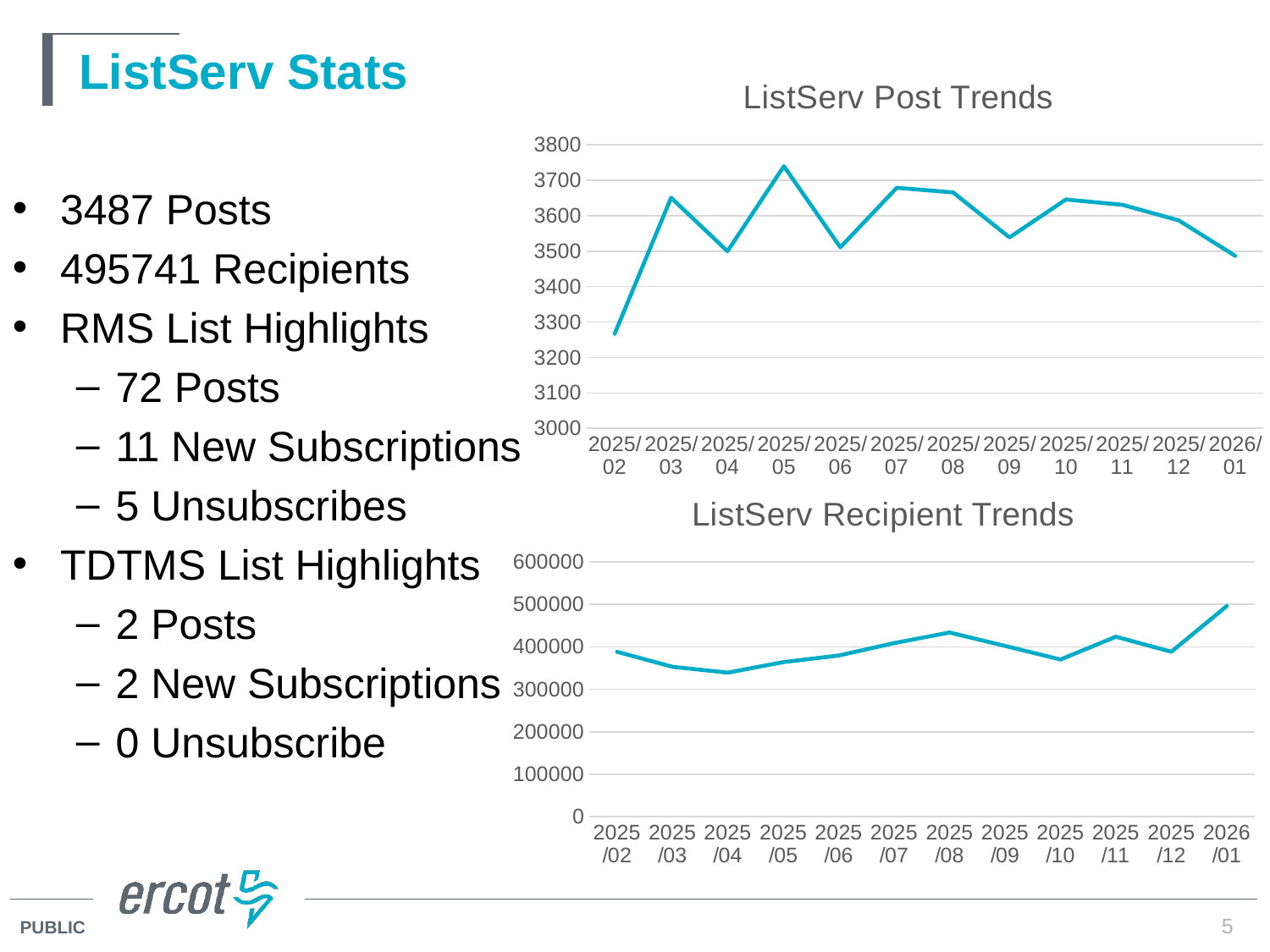
What kind of chart is the ListServ Recipient Trends chart? line chart On the ListServ Recipient Trends chart, which month has the highest value? 2026/01 On the ListServ Post Trends chart, which month has the highest value? 2025/05 What kind of chart is the ListServ Post Trends chart? line chart On the ListServ Post Trends chart, which month has the lowest value? 2025/02 What is the title of the lower chart on the slide? ListServ Recipient Trends On the ListServ Recipient Trends chart, which month has the lowest value? 2025/04 On the ListServ Post Trends chart, is the value for 2025/05 greater or less than 3700? greater How many data points are plotted on the ListServ Post Trends chart? 12 On the ListServ Post Trends chart, is the value for 2025/02 greater or less than 3300? less On the ListServ Post Trends chart, which is larger, the value for 2025/03 or the value for 2025/04? 2025/03 On the ListServ Recipient Trends chart, is the value for 2025/08 greater or less than 400000? greater